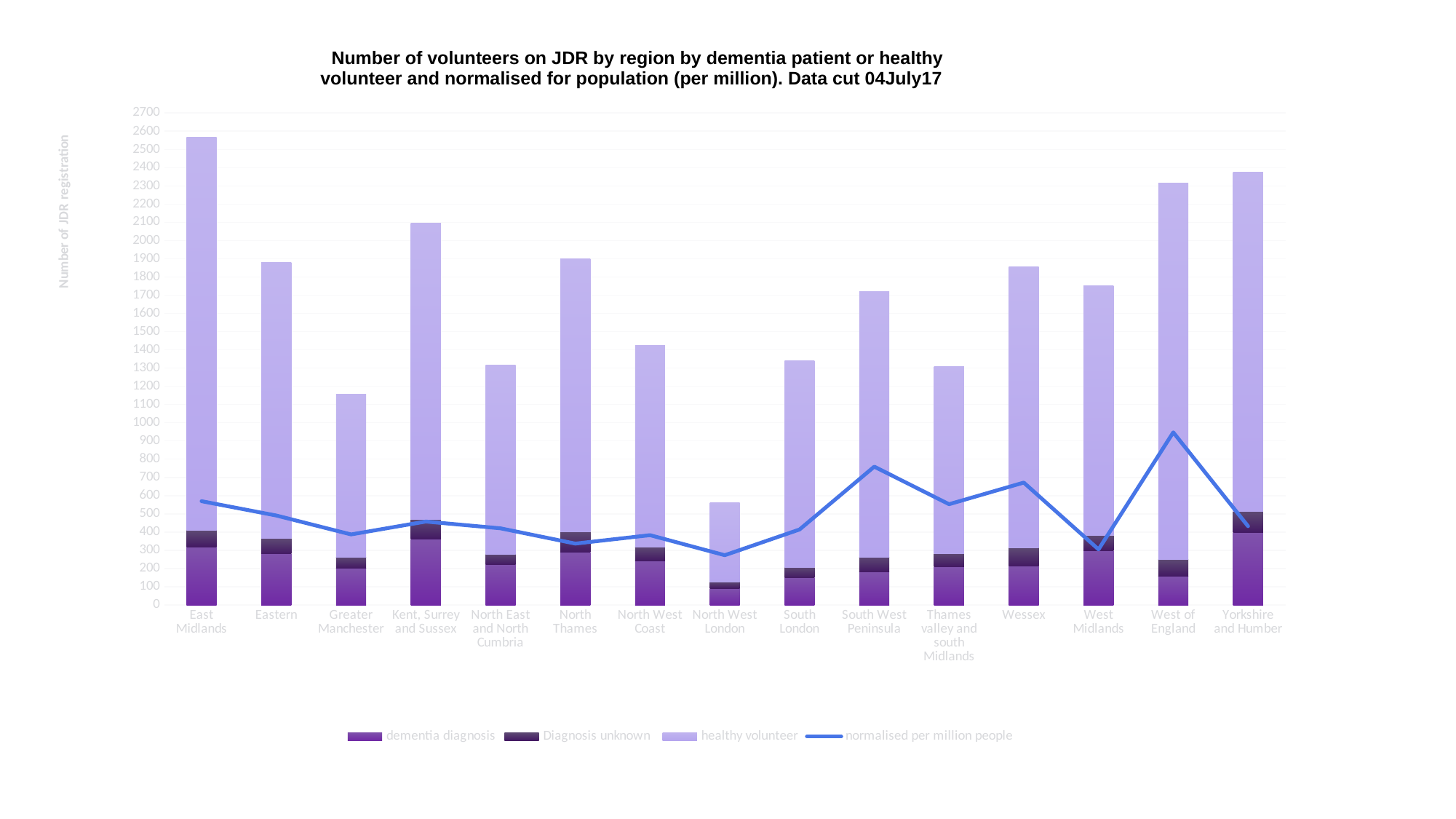
Which region has the tallest stacked bar? East Midlands Is the total bar for North West London greater or less than 600? less How many regions are shown on the x axis? 15 Which region has the shortest stacked bar? North West London How many series does the legend list? 4 Which has the taller stacked bar, Wessex or South West Peninsula? Wessex Which region has the lowest value on the 'normalised per million people' line? North West London Is the total bar for East Midlands greater or less than 2500? greater What kind of chart is shown on the slide? Bar chart with a line What is the label of the y axis? Number of JDR registration Is the 'normalised per million people' value for West of England greater or less than 900? greater Which region has the highest value on the 'normalised per million people' line? West of England